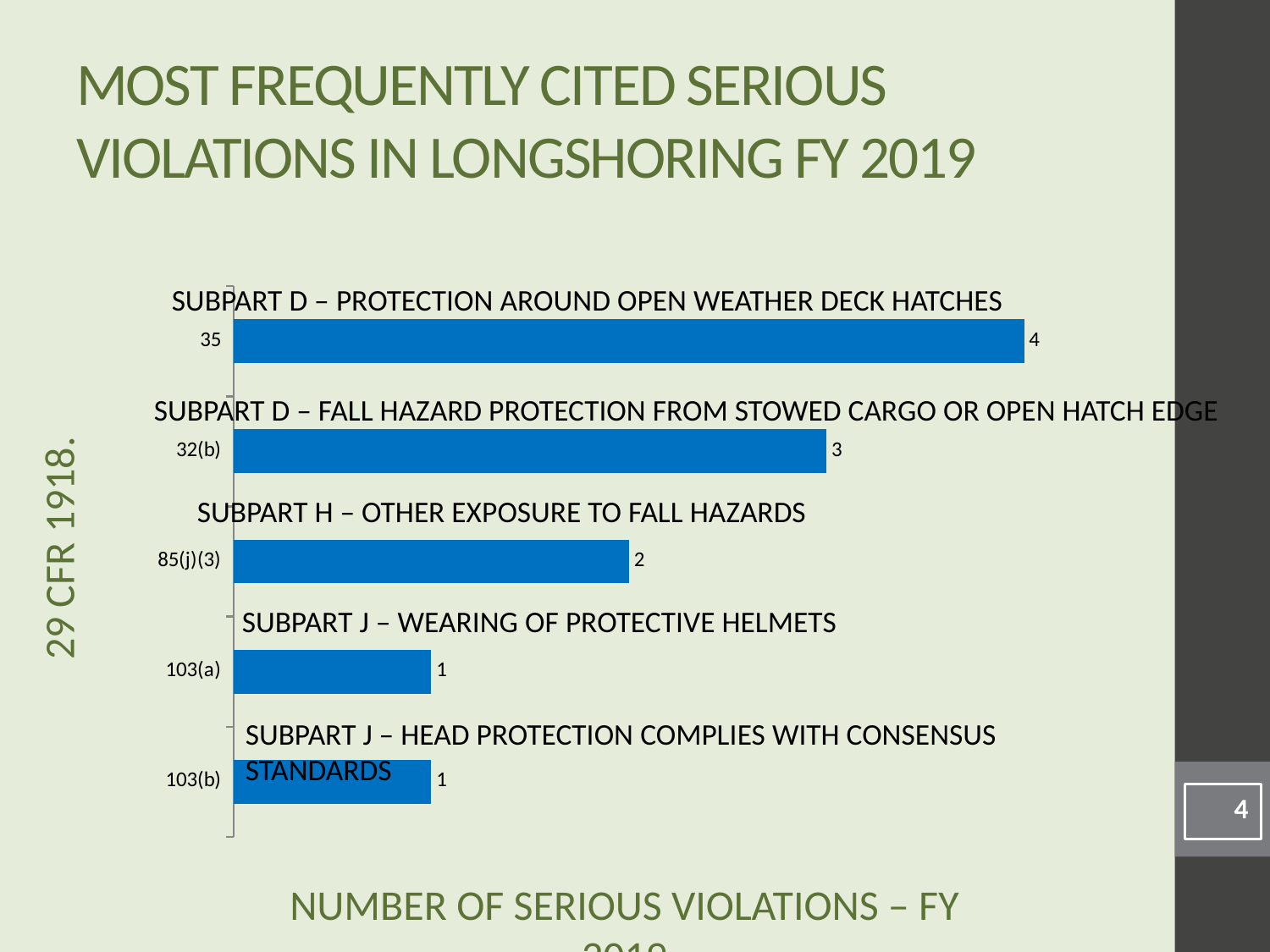
What kind of chart is shown on the slide? Bar chart Which has more serious violations, 32(b) or 85(j)(3)? 32(b) What is the total number of serious violations across all five standards shown? 11 What is the label on the vertical axis of the chart? 29 CFR 1918. What is the difference in serious violations between 35 and 32(b)? 1 Which standard has the highest number of serious violations? 35 What is the number of serious violations for 29 CFR 1918.32(b)? 3 What is the difference in serious violations between 35 and 85(j)(3)? 2 What is the number of serious violations for 29 CFR 1918.35? 4 How many standards (categories) are shown in the chart? 5 What is the number of serious violations for 29 CFR 1918.85(j)(3)? 2 What is the number of serious violations for 29 CFR 1918.103(a)? 1